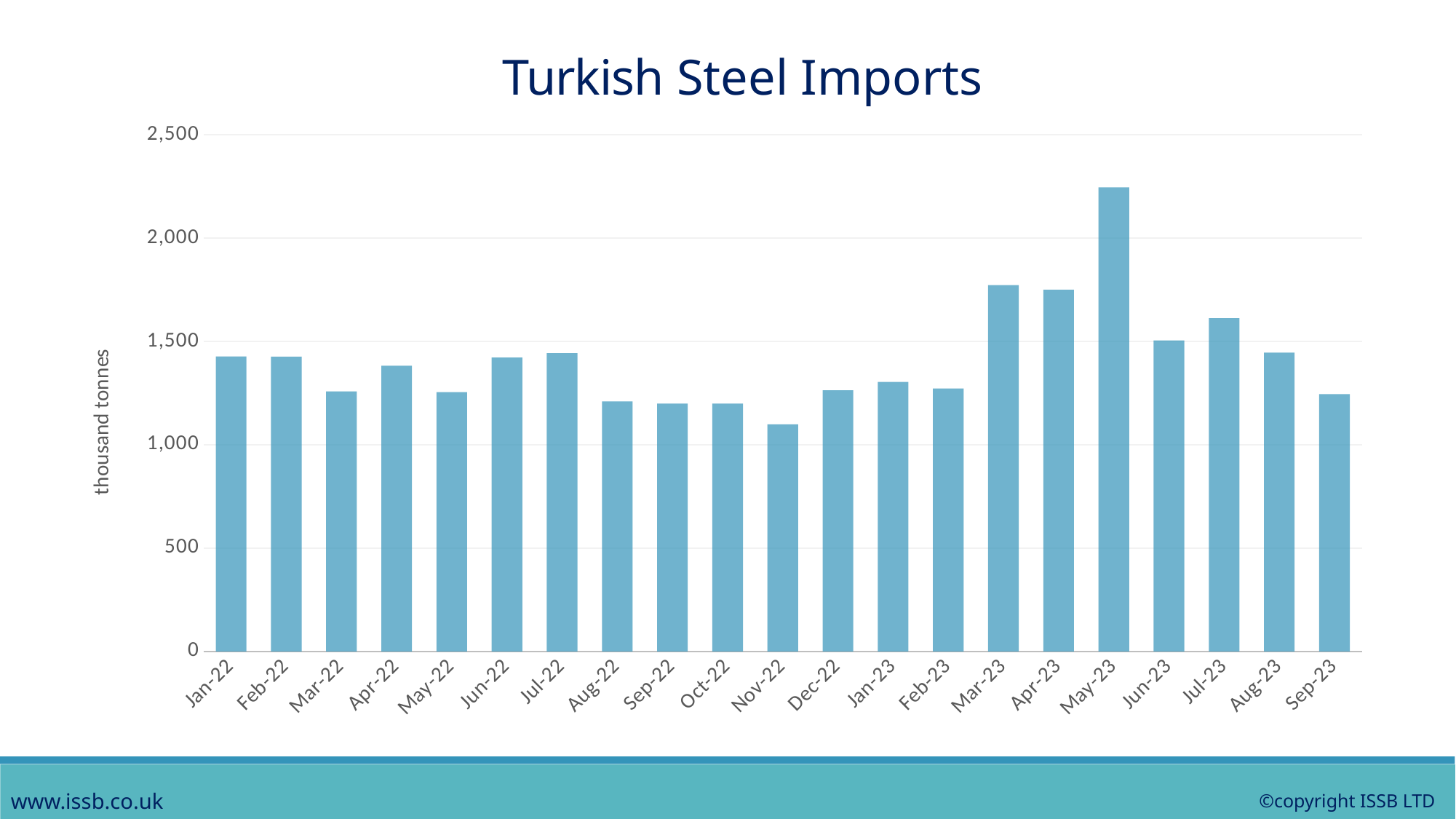
Is the value for Nov-22 greater or less than 1,000? greater Is the value for May-23 greater or less than 2,000? greater Which month has the lowest value for Turkish steel imports? Nov-22 How many months are plotted on the chart? 21 What kind of chart is shown on the slide? bar chart What unit is shown on the vertical axis label? thousand tonnes Which month has the highest value for Turkish steel imports? May-23 Which is larger, the value for Nov-22 or the value for Jan-23? Jan-23 Which is larger, the value for Mar-23 or the value for Sep-23? Mar-23 Is the value for Sep-22 greater or less than 1,500? less Do the values rise or fall from Feb-23 to May-23? rise